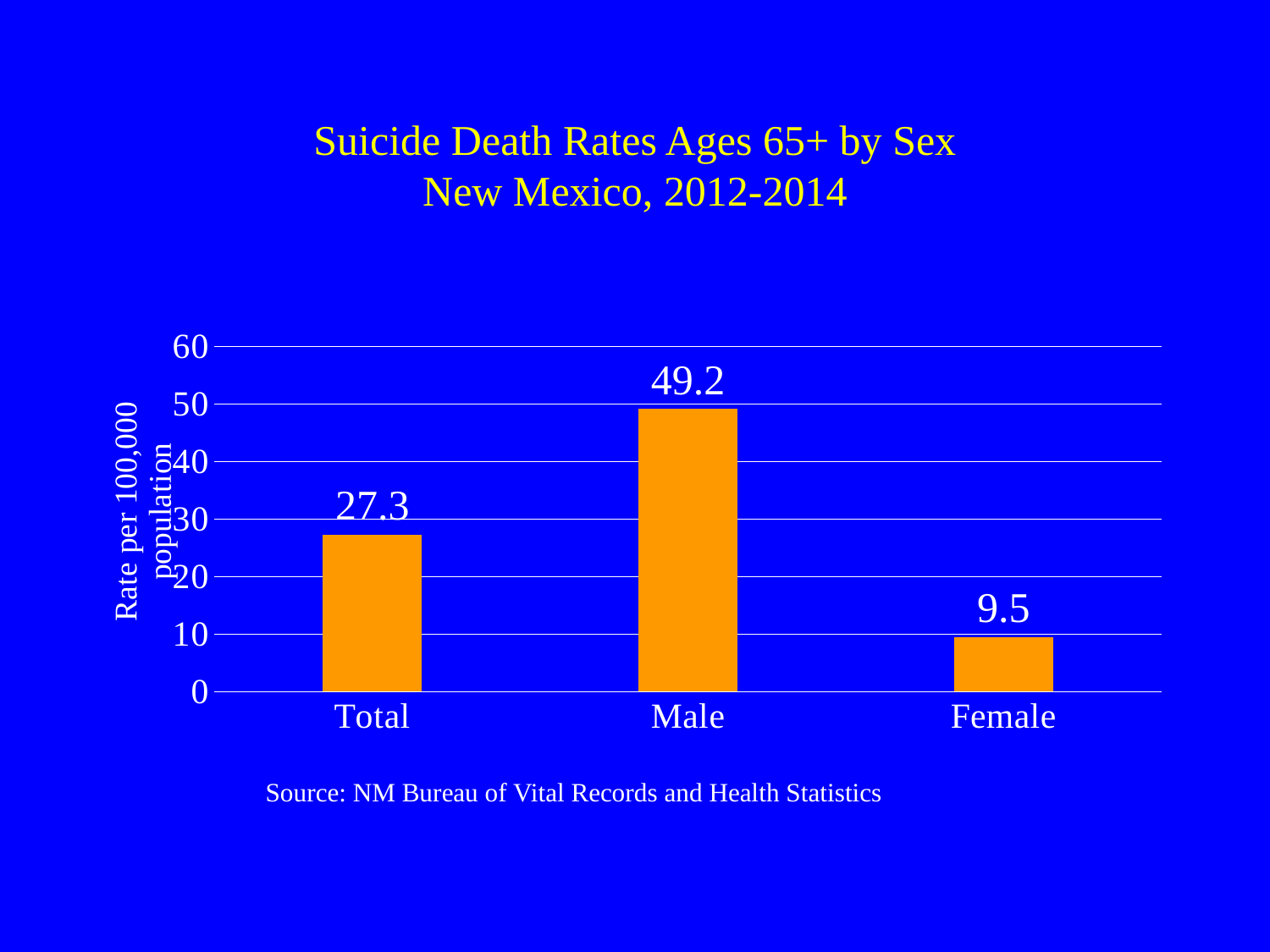
What is the suicide death rate for Female? 9.5 What is the difference between the Male and Female suicide death rates? 39.7 What is the suicide death rate for Male? 49.2 What is the label of the y axis? Rate per 100,000 population What is the difference between the Male and Total suicide death rates? 21.9 Is the value for Male greater or less than 40? greater What is the suicide death rate for Total? 27.3 Which category has the highest suicide death rate? Male What kind of chart is shown on the slide? bar chart Which is larger, the rate for Total or the rate for Female? Total How many categories are shown on the x axis? 3 Which category has the lowest suicide death rate? Female